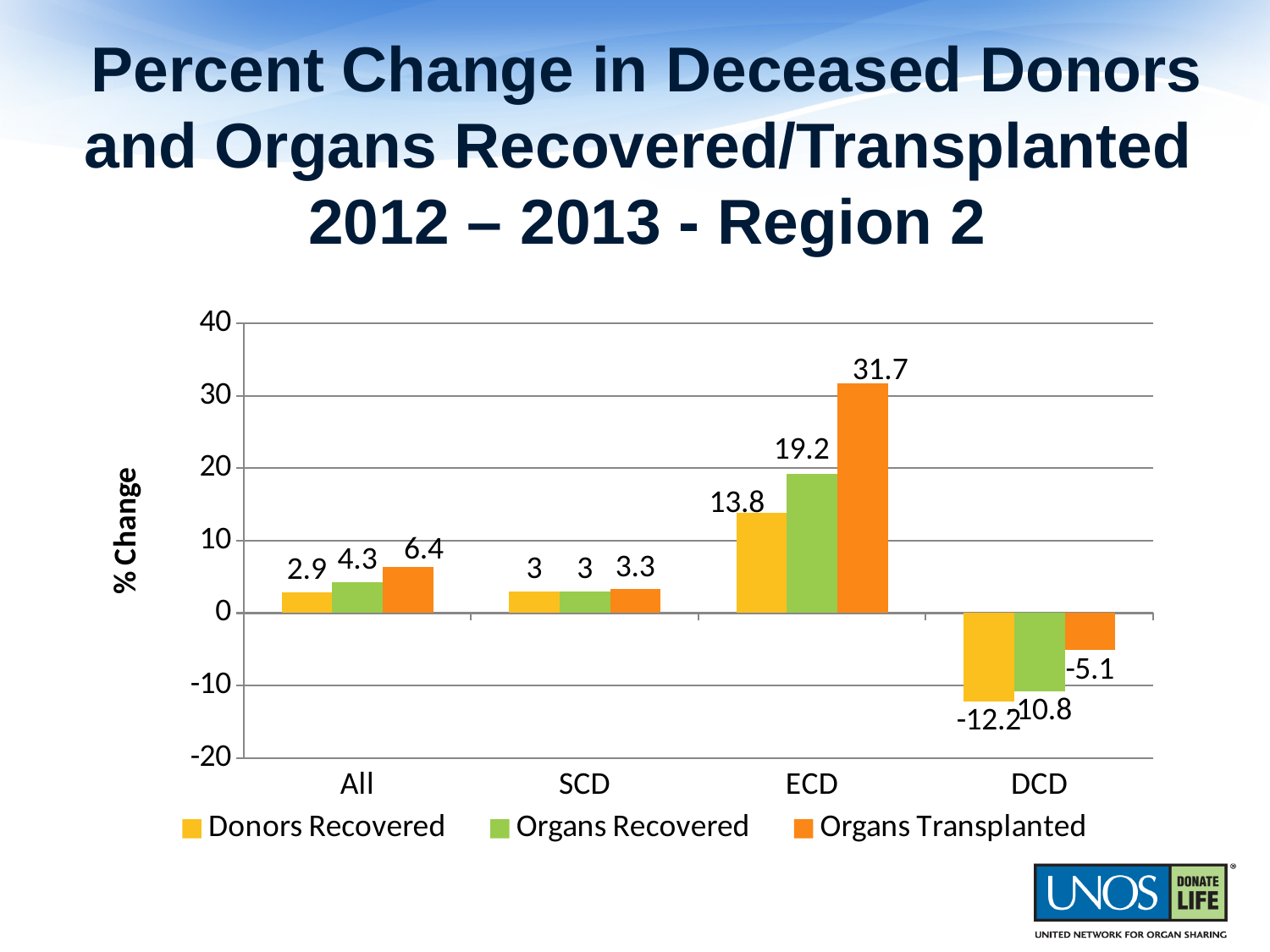
Which category has the highest value for Organs Transplanted? ECD What type of chart is shown on the slide? Bar chart How many categories are shown on the x axis? 4 Which category has the lowest value for Donors Recovered? DCD What is the value for Organs Recovered in the ECD category? 19.2 What is the difference between Organs Transplanted and Donors Recovered in the ECD category? 17.9 How many series does the legend list? 3 What is the label of the y axis? % Change What is the value for Organs Transplanted in the DCD category? -5.1 What is the value for Donors Recovered in the All category? 2.9 Which is larger in the All category: Organs Recovered or Organs Transplanted? Organs Transplanted What is the value for Organs Transplanted in the ECD category? 31.7